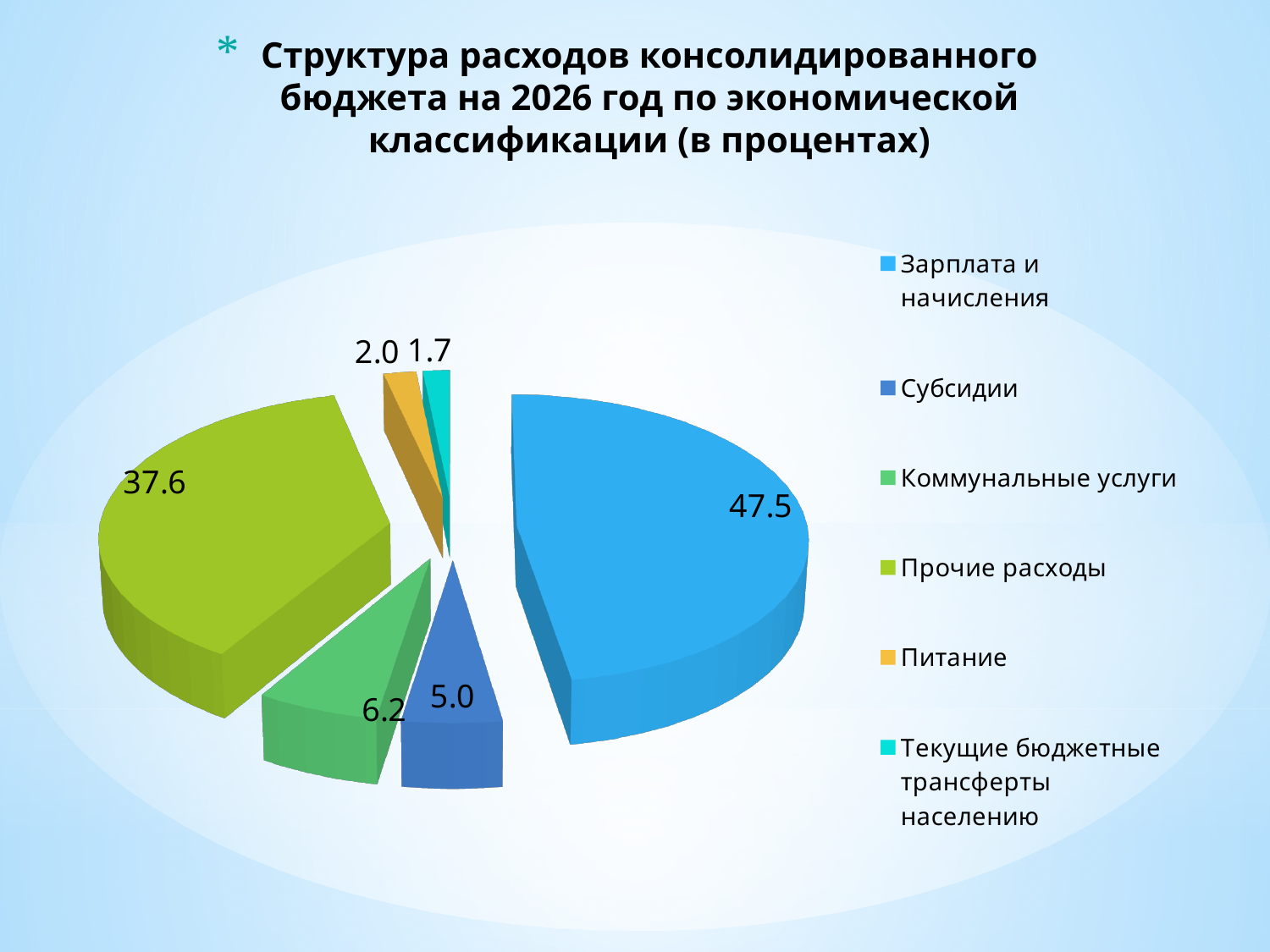
What is the value for Субсидии? 5.0 What is the value for Коммунальные услуги? 6.2 Which category has the largest share of the pie? Зарплата и начисления What type of chart is shown on the slide? Pie chart What is the difference between the values for Зарплата и начисления and Прочие расходы? 9.9 Which category has the smallest share of the pie? Текущие бюджетные трансферты населению What is the value for Прочие расходы? 37.6 What is the value for Текущие бюджетные трансферты населению? 1.7 Which is larger, Коммунальные услуги or Субсидии? Коммунальные услуги What is the value for Питание? 2.0 What is the value for Зарплата и начисления? 47.5 How many categories does the legend list? 6